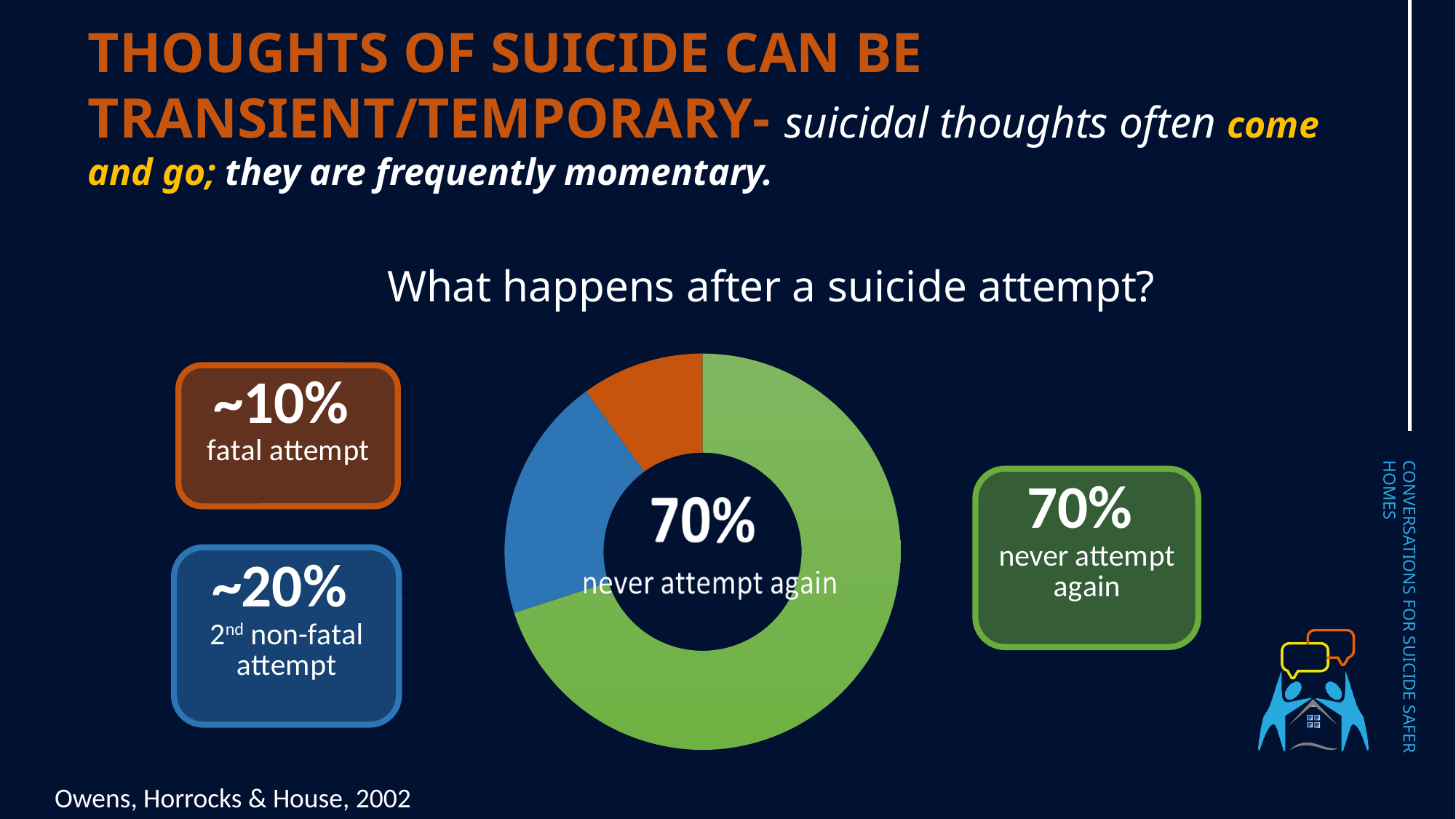
What kind of chart is shown under "What happens after a suicide attempt?"? Pie chart (donut) What percentage of people never attempt again, according to the chart? 70% How many slices does the donut chart have? 3 Which outcome has the smallest slice of the donut chart? fatal attempt What share of the donut chart does the "never attempt again" slice represent? 70% Which is larger: the slice for 2nd non-fatal attempt or the slice for fatal attempt? 2nd non-fatal attempt What colour is the "never attempt again" slice in the donut chart? Green What text is printed in the centre of the donut chart? 70% never attempt again What value is given for a 2nd non-fatal attempt? ~20% What value is given for a fatal attempt? ~10% What is the title of the chart on the slide? What happens after a suicide attempt? Which outcome has the largest slice of the donut chart? never attempt again